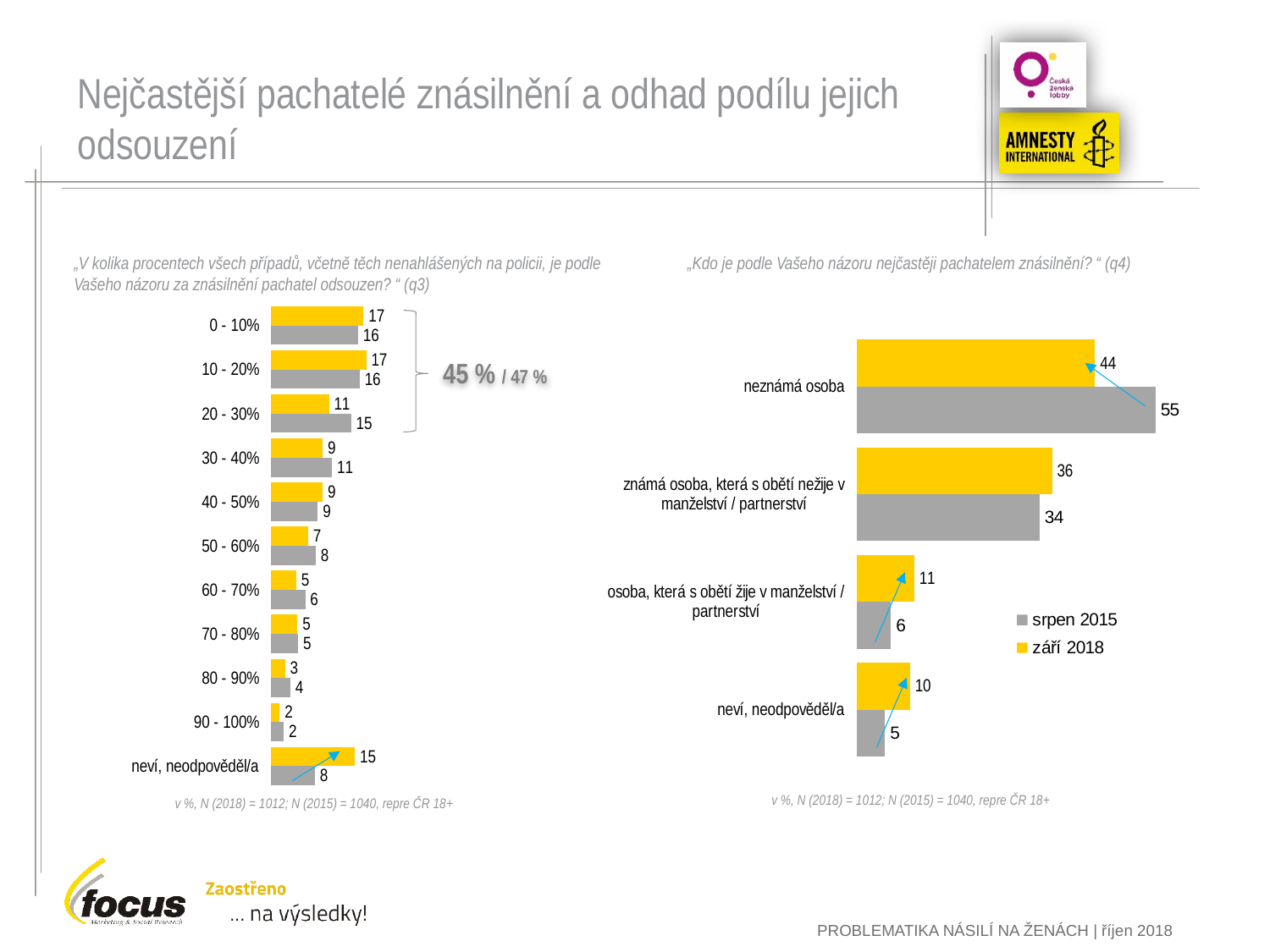
In the left chart (q3), how many categories are shown on the vertical axis? 11 In the right chart (q4), which category has the highest value for září 2018? neznámá osoba In the right chart (q4), which category has the lowest value for srpen 2015? neví, neodpověděl/a In the right chart (q4, 'Kdo je podle Vašeho názoru nejčastěji pachatelem znásilnění?'), what is the value for 'neznámá osoba' in září 2018? 44 In the right chart (q4), what is the value for 'neznámá osoba' in srpen 2015? 55 In the right chart (q4), which colour represents the series 'srpen 2015'? grey In the right chart (q4), how many series does the legend list? 2 In the right chart (q4), what is the difference between the srpen 2015 and září 2018 values for 'neznámá osoba'? 11 In the left chart (q3), what is the value of the grey bar for '20 - 30%'? 15 In the right chart (q4), which series is larger for 'osoba, která s obětí žije v manželství / partnerství': srpen 2015 or září 2018? září 2018 In the left chart (q3), what is the value of the yellow bar for 'neví, neodpověděl/a'? 15 What type of chart is the left chart (q3)? bar chart